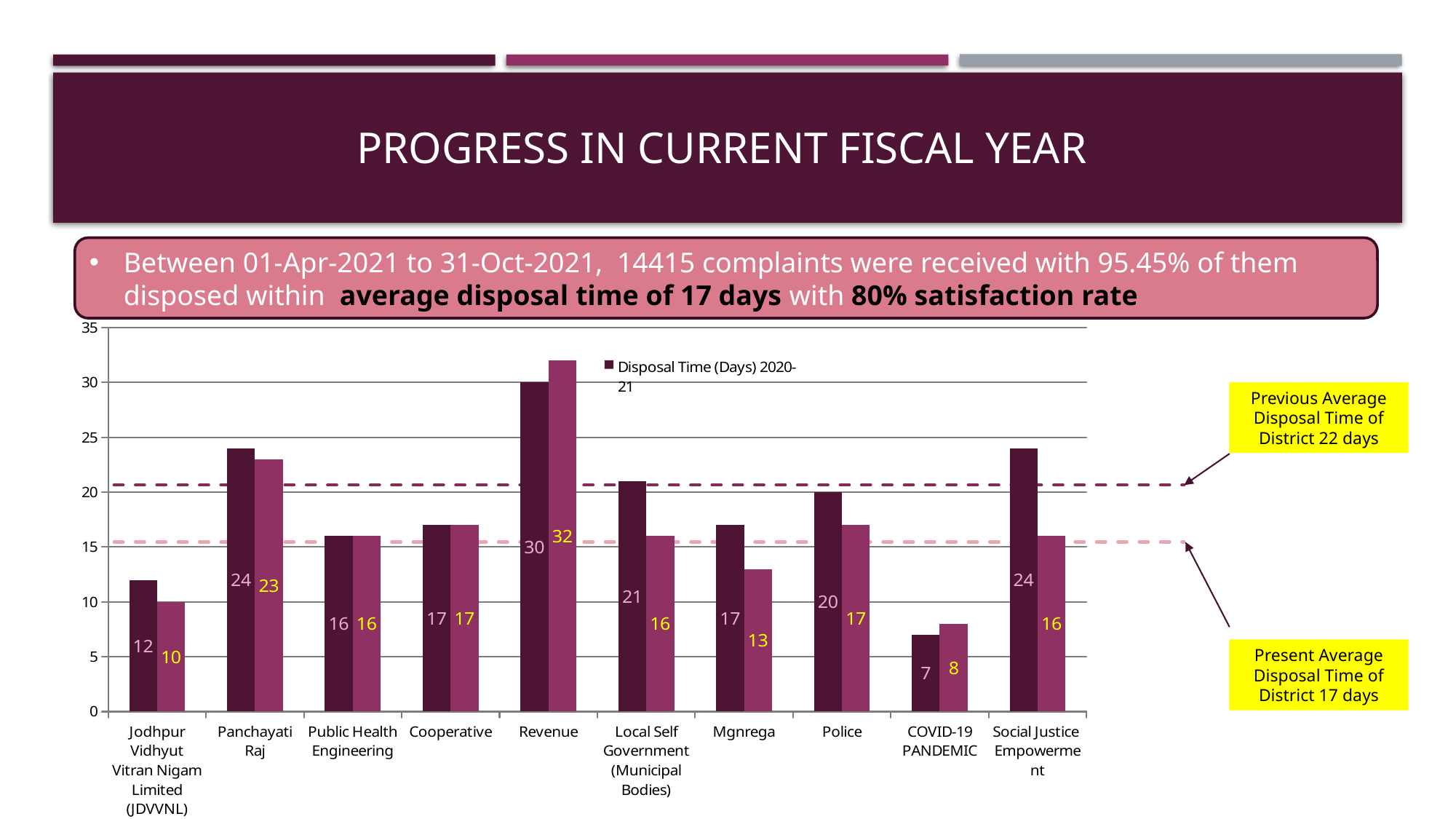
What is the Disposal Time (Days) 2020-21 value for Revenue? 30 What type of chart is shown on the slide? bar chart What is the difference between the Disposal Time (Days) 2020-21 value for Social Justice Empowerment and its lighter (second) bar value? 8 What is the value of the lighter (second) bar for COVID-19 PANDEMIC? 8 Which is larger for Panchayati Raj: the Disposal Time (Days) 2020-21 bar or the lighter (second) bar? Disposal Time (Days) 2020-21 Is the Disposal Time (Days) 2020-21 value for Local Self Government (Municipal Bodies) greater or less than 15? greater How many departments (categories) are shown on the x axis of the chart? 10 What is the Disposal Time (Days) 2020-21 value for Police? 20 What is the value of the lighter (second) bar for Mgnrega? 13 Which department has the highest Disposal Time (Days) 2020-21 value? Revenue Which department has the lowest Disposal Time (Days) 2020-21 value? COVID-19 PANDEMIC What is the series name shown in the chart legend? Disposal Time (Days) 2020-21